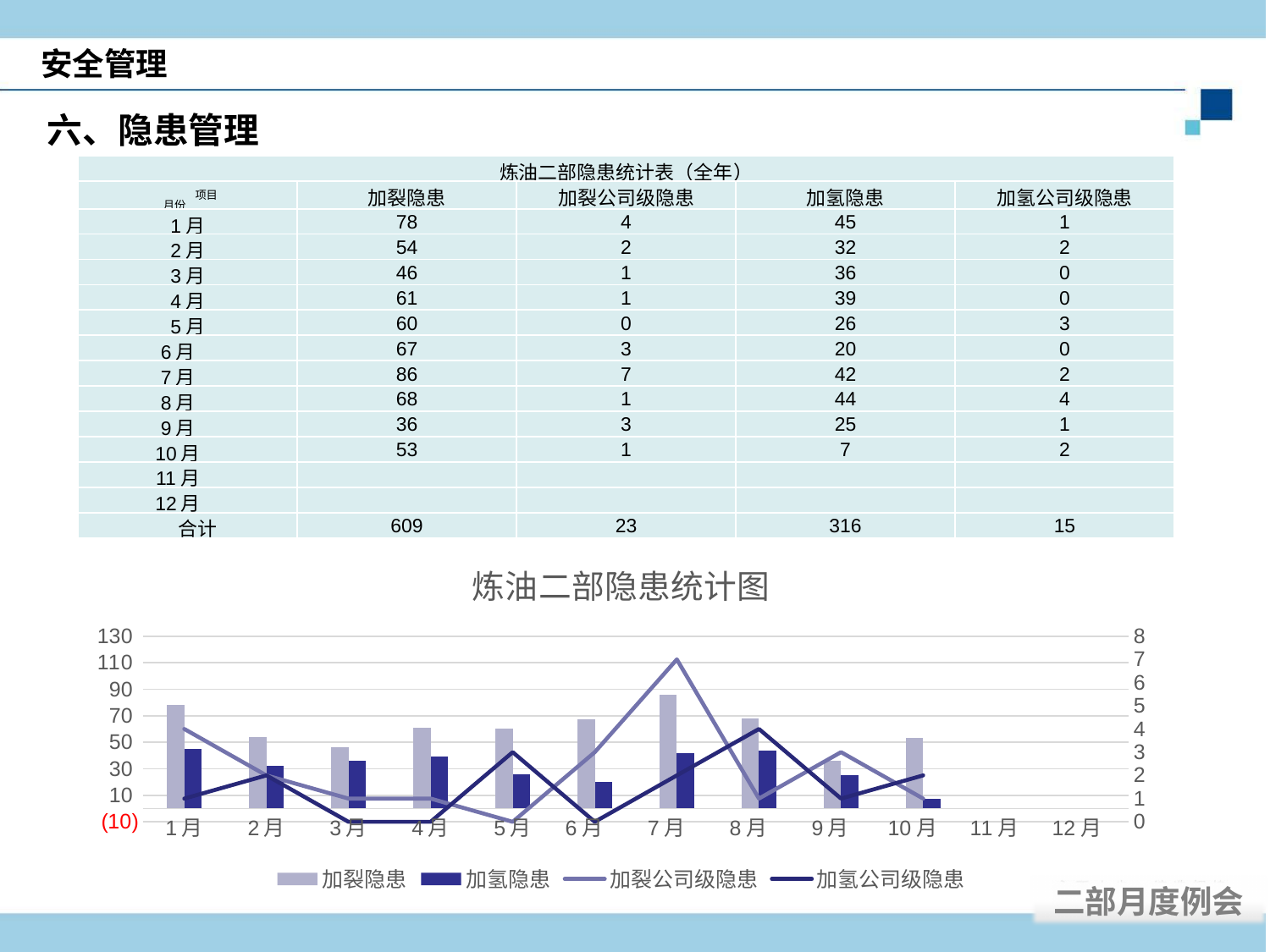
In which month does the 加氢公司级隐患 line reach its highest point? 8月 How many series does the chart legend list? 4 In which month is the 加氢隐患 bar the lowest? 10月 Which is larger, the 加裂隐患 value for 1月 or for 2月? 1月 What is the title of the chart on the slide? 炼油二部隐患统计图 Is the 加氢隐患 value for 6月 greater or less than 30? less Is the 加裂隐患 value for 7月 greater or less than 70? greater In which month does the 加裂公司级隐患 line reach its peak? 7月 How many month categories are shown on the x axis of the chart? 12 Does the 加裂公司级隐患 line rise or fall from 5月 to 7月? rise In which month is the 加裂隐患 bar the highest? 7月 What kind of chart is shown on the slide? A combined bar and line chart